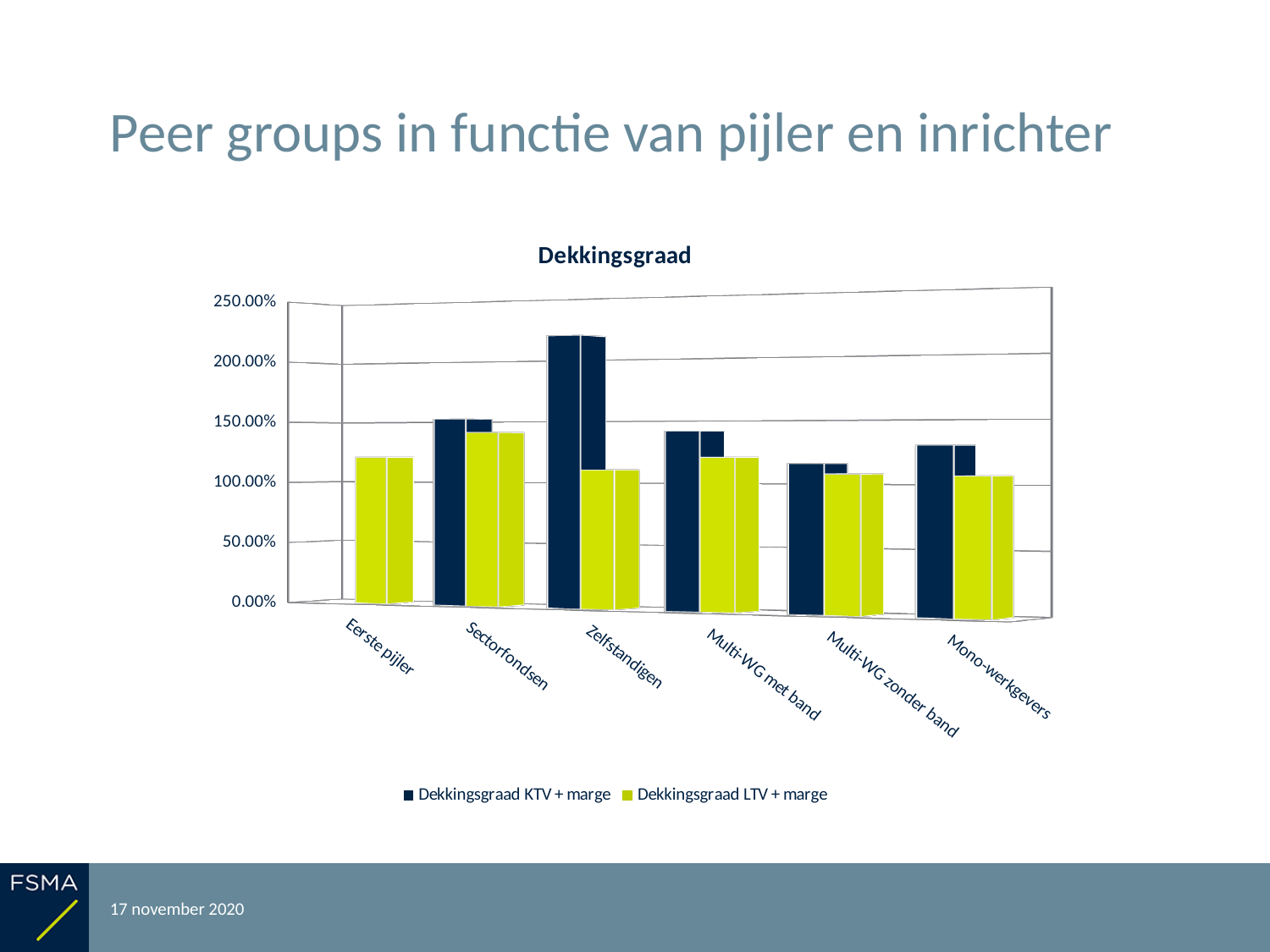
Is the Dekkingsgraad KTV + marge value for Zelfstandigen greater or less than 200.00%? greater What kind of chart is shown on the slide? Bar chart What is the title of the chart? Dekkingsgraad Is the Dekkingsgraad LTV + marge value for Zelfstandigen greater or less than 150.00%? less Which series is shown in dark navy bars? Dekkingsgraad KTV + marge How many categories are shown on the x axis? 6 Which category has the highest value for Dekkingsgraad KTV + marge? Zelfstandigen Which category has a larger Dekkingsgraad KTV + marge value: Sectorfondsen or Multi-WG zonder band? Sectorfondsen Which category has the highest value for Dekkingsgraad LTV + marge? Sectorfondsen Which is larger for Zelfstandigen: Dekkingsgraad KTV + marge or Dekkingsgraad LTV + marge? Dekkingsgraad KTV + marge Is the Dekkingsgraad KTV + marge value for Sectorfondsen greater or less than 100.00%? greater How many series does the legend list? 2